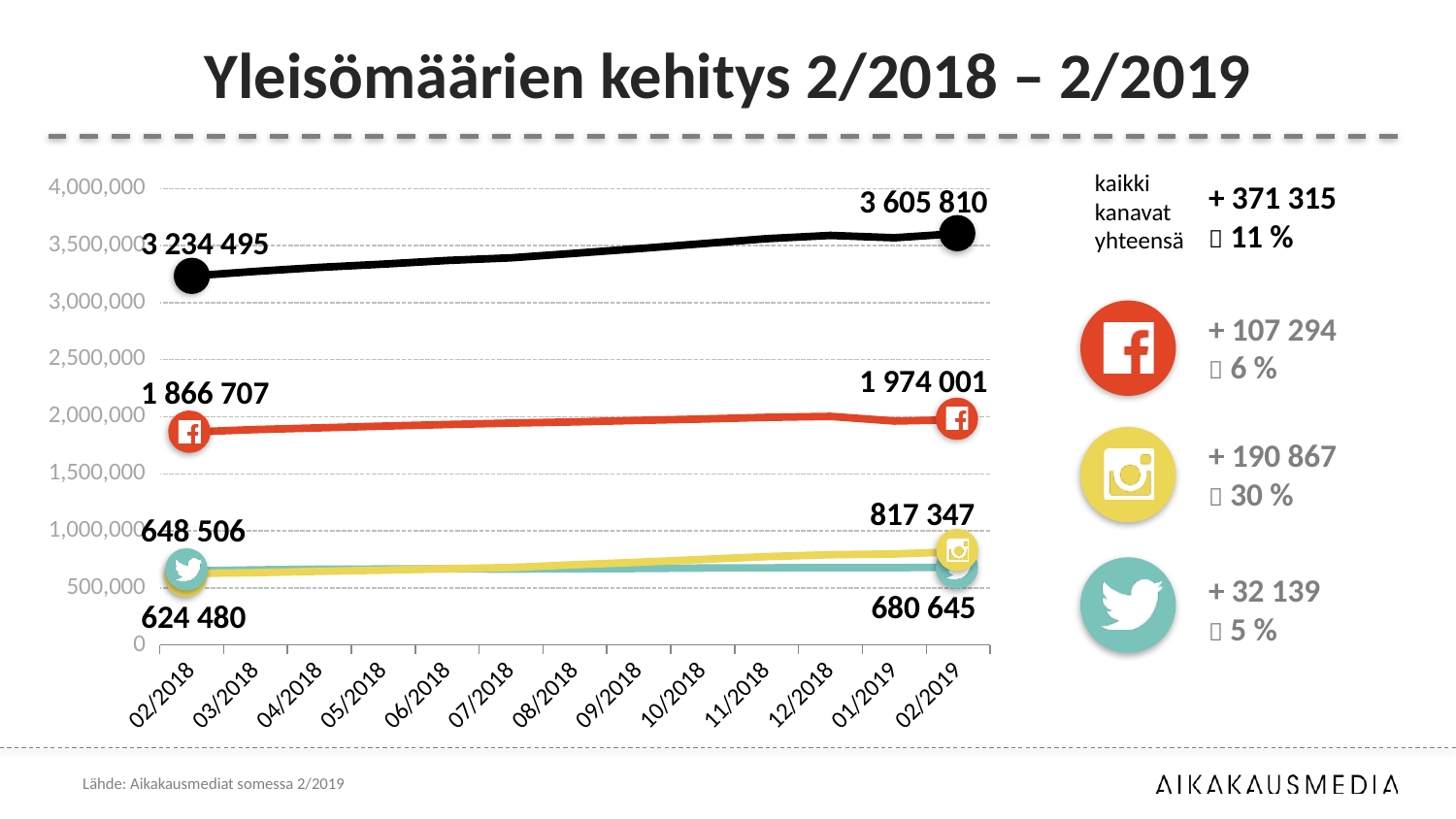
What is the value of the Instagram line at 02/2019? 817 347 Is the value of the black line at 02/2019 greater or less than 3,500,000? greater What kind of chart is shown on the slide? line chart What is the title of the chart on the slide? Yleisömäärien kehitys 2/2018 – 2/2019 How many months are shown on the x axis of the chart? 13 What is the value of the black line (all channels total) at 02/2018? 3 234 495 By how much did the black line (all channels total) increase from 02/2018 to 02/2019? 371 315 Which line has the highest value at 02/2019? the black line (all channels total) What is the value of the Facebook line at 02/2019? 1 974 001 What is the value of the Twitter line at 02/2019? 680 645 What is the value of the black line (all channels total) at 02/2019? 3 605 810 What is the value of the Facebook line at 02/2018? 1 866 707